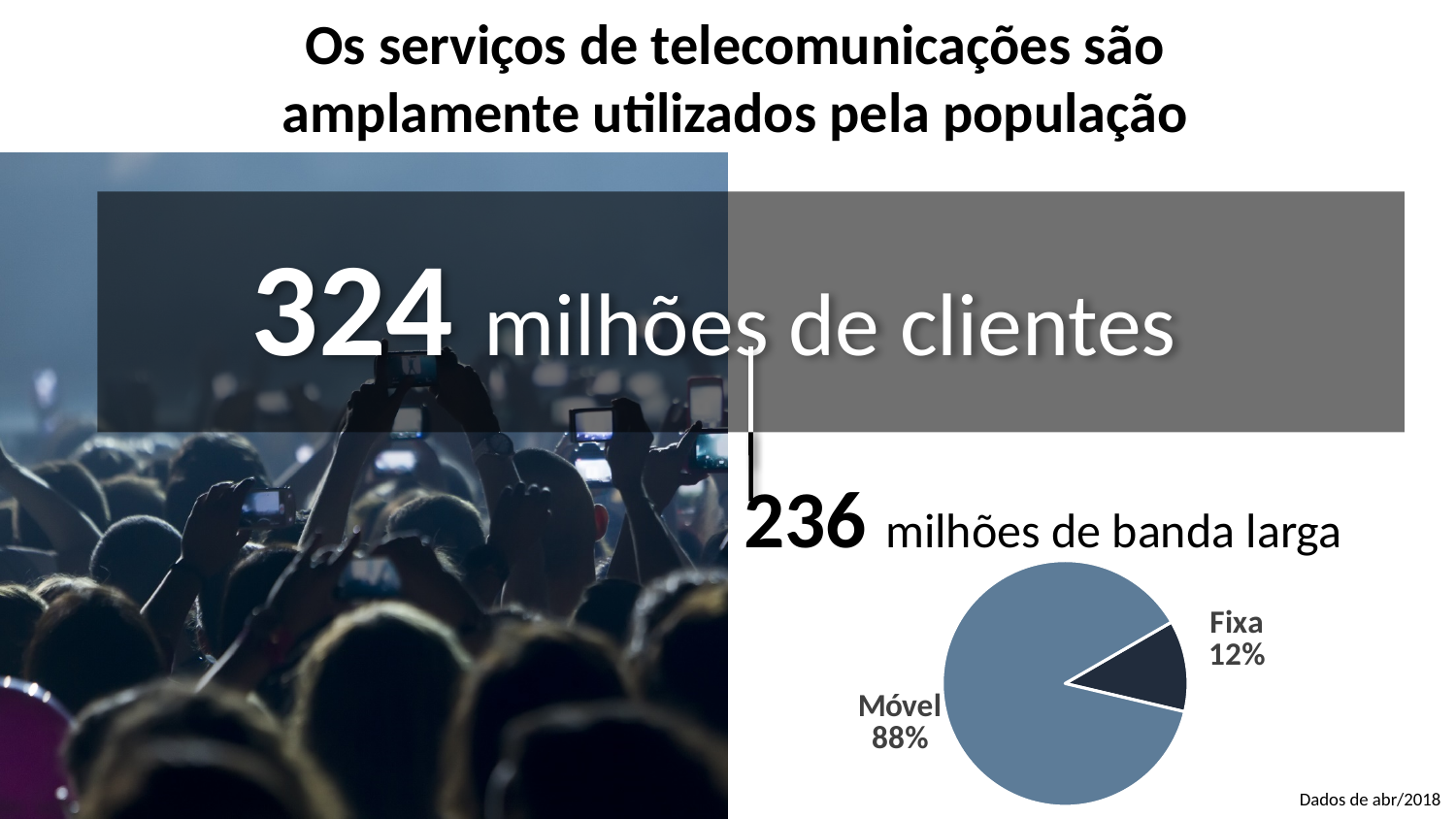
What is the date of the data shown on the slide? abr/2018 Which slice of the pie chart is the largest? Móvel Which slice of the pie chart is the smallest? Fixa What share of the pie chart does Móvel represent? 88% What share of the pie chart does Fixa represent? 12% What total figure is given above the pie chart for broadband (banda larga)? 236 milhões What is the difference in percentage points between the Móvel and Fixa slices? 76 Which is larger in the pie chart, Móvel or Fixa? Móvel How many slices does the pie chart have? 2 What kind of chart is shown on the slide? pie chart